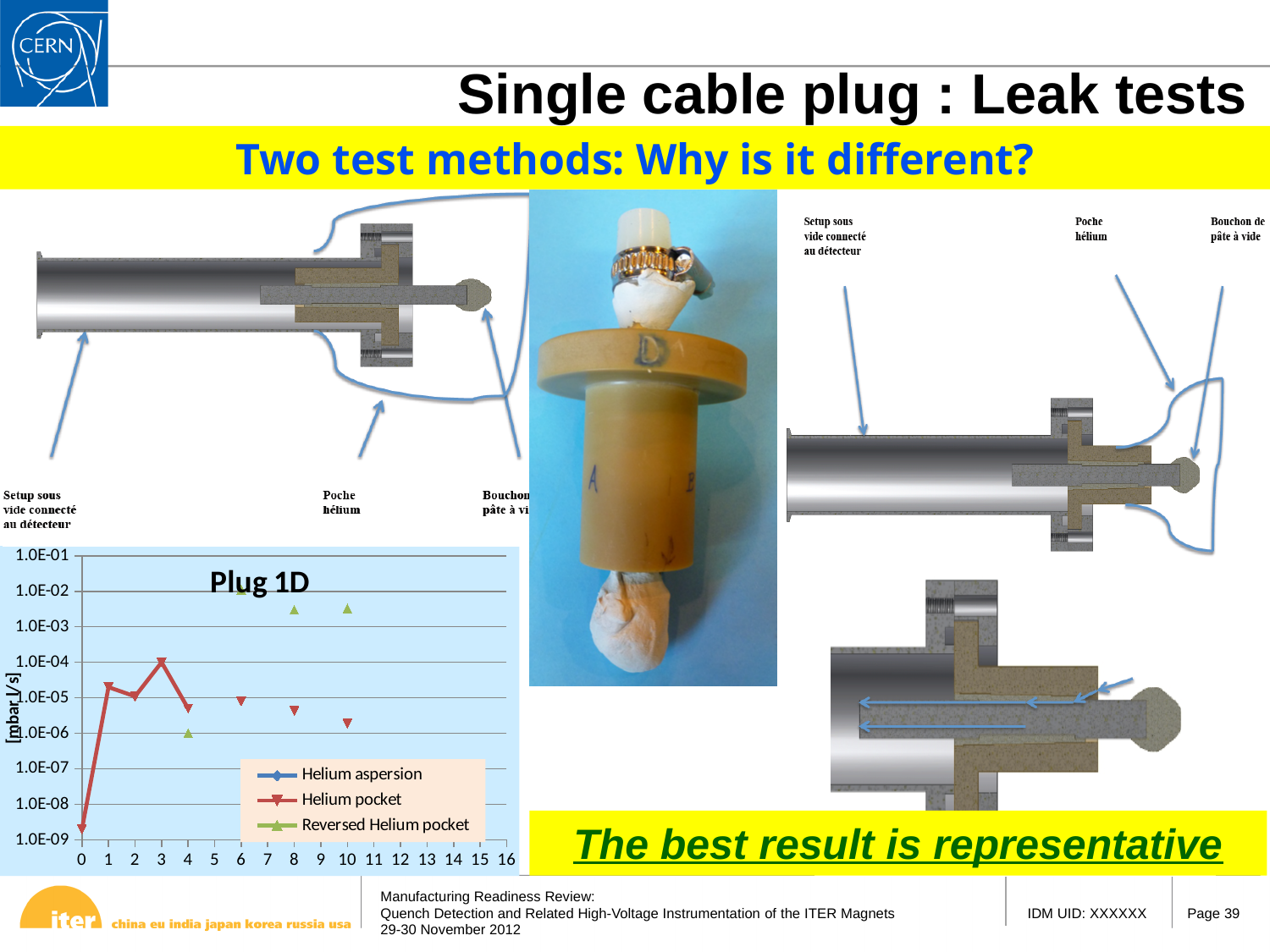
What unit is shown on the y-axis label of the Plug 1D chart? [mbar l/s] In the Plug 1D chart, at which x value does the Helium pocket series reach its highest point? 3 What is the title of the chart on the slide? Plug 1D In the Plug 1D chart, is the Reversed Helium pocket value at x = 6 greater or less than 1.0E-03? greater In the Plug 1D chart, is the Reversed Helium pocket value at x = 4 greater or less than 1.0E-05? less In the Plug 1D chart, is the Helium pocket value at x = 10 greater or less than 1.0E-05? less How many series does the legend of the Plug 1D chart list? 3 What kind of chart is the Plug 1D chart? line chart In the Plug 1D chart, do the Helium pocket values rise or fall from x = 3 to x = 10? fall In the Plug 1D chart, which series reaches the highest value overall? Reversed Helium pocket In the Plug 1D chart, at x = 8, which series has the larger value: Helium pocket or Reversed Helium pocket? Reversed Helium pocket